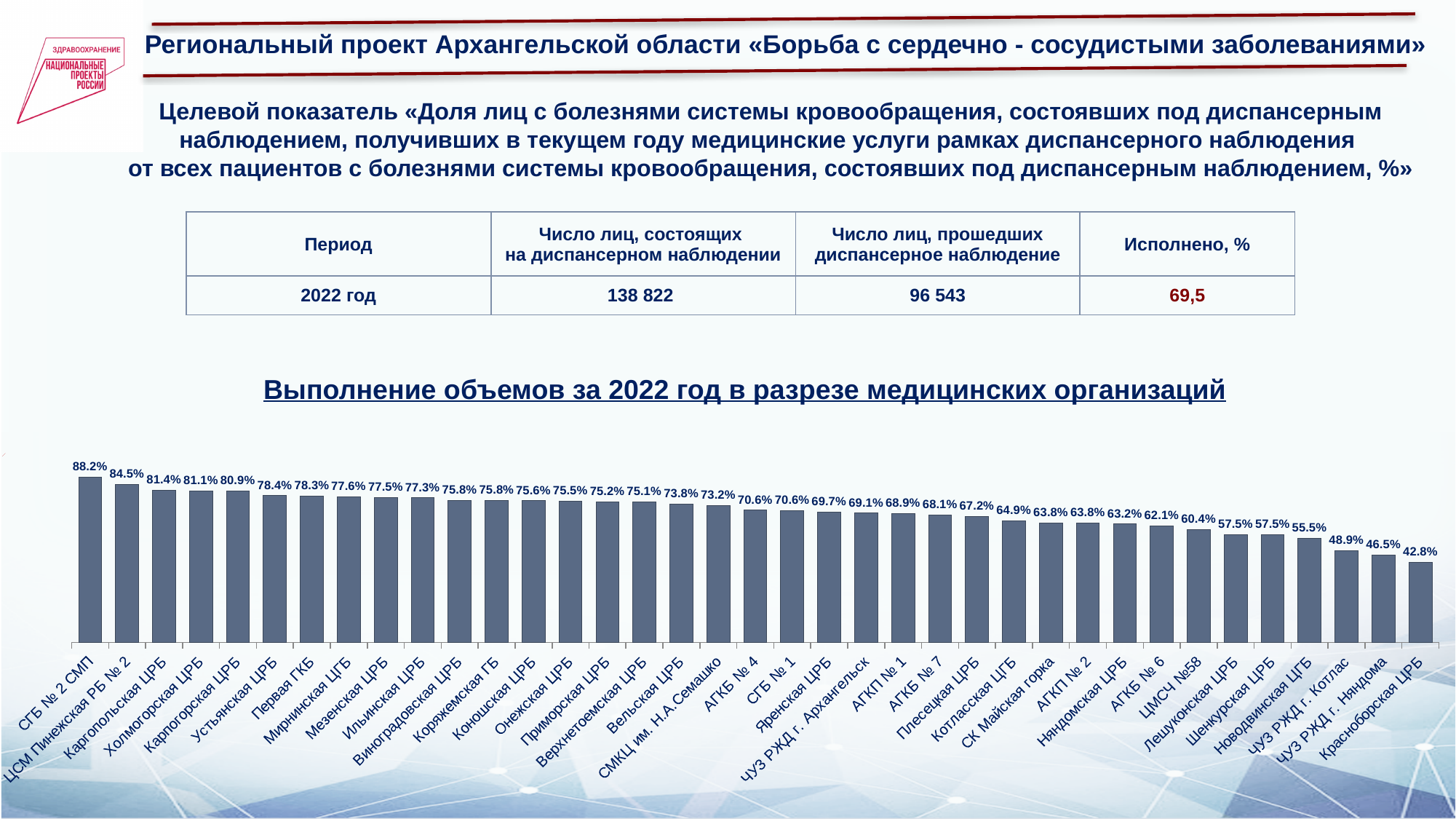
Which medical organization has the lowest value in the bar chart? Красноборская ЦРБ Which medical organization has the highest value in the bar chart? СГБ № 2 СМП What is the value shown for Новодвинская ЦГБ in the bar chart? 55.5% What is the difference between the values for СГБ № 2 СМП and Красноборская ЦРБ in the bar chart? 45.4% Do the values in the bar chart rise or fall from left to right? Fall What type of chart is shown under the heading «Выполнение объемов за 2022 год в разрезе медицинских организаций»? Bar chart What is the difference between the values for Каргопольская ЦРБ and Плесецкая ЦРБ in the bar chart? 14.2% What is the value shown for Котласская ЦГБ in the bar chart? 64.9% What is the value shown for ЧУЗ РЖД г. Котлас in the bar chart? 48.9% How many medical organizations are shown in the bar chart? 37 Which has a larger value in the bar chart, Вельская ЦРБ or АГКБ № 6? Вельская ЦРБ What is the value shown for Первая ГКБ in the bar chart? 78.3%